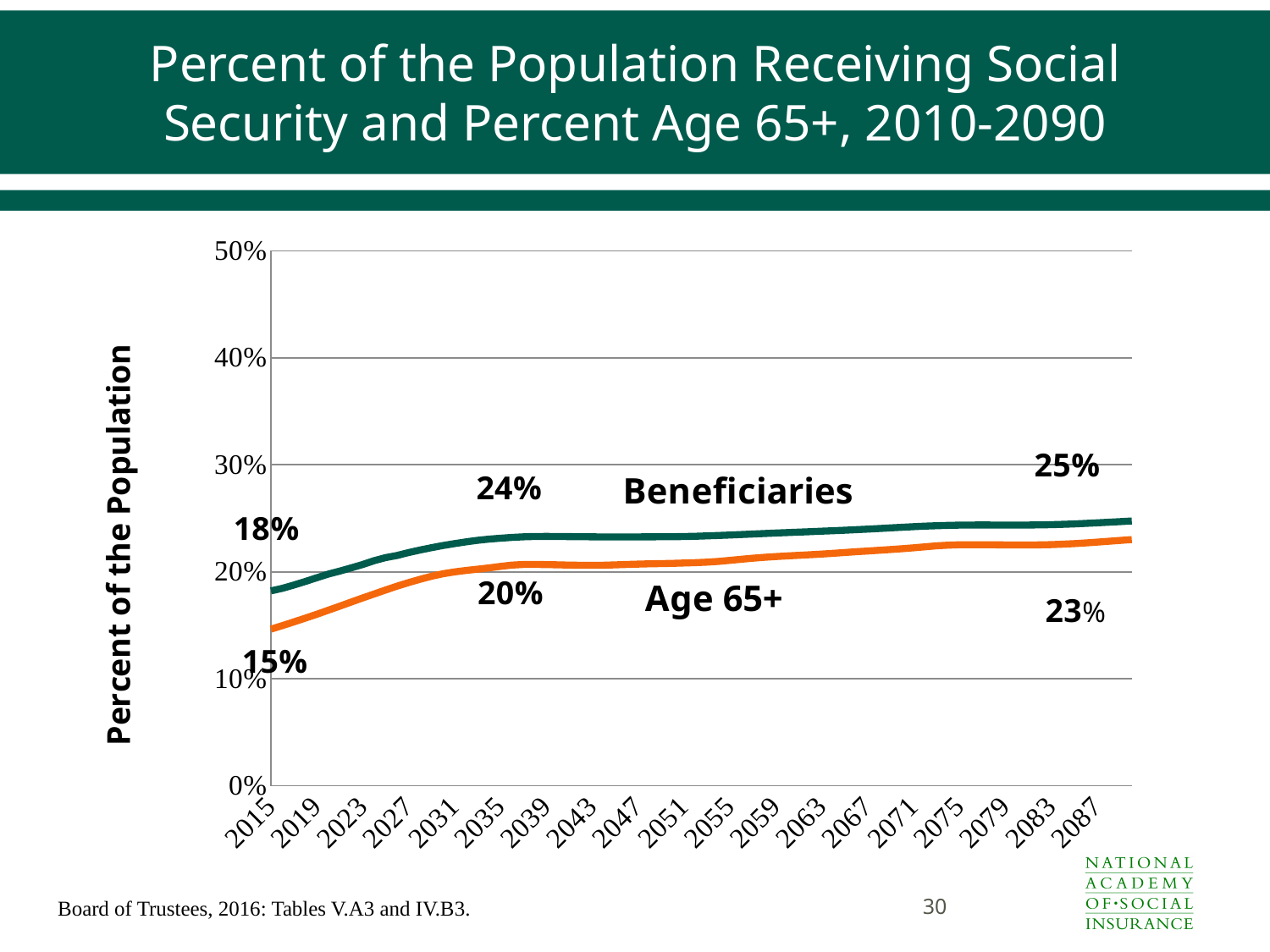
What is the labelled value for Beneficiaries at the end of the period? 25% Which series is higher throughout the chart, Beneficiaries or Age 65+? Beneficiaries What is the labelled value for Age 65+ at the end of the period? 23% What is the label on the vertical axis? Percent of the Population What is the labelled value for Age 65+ around 2035? 20% What is the difference between the labelled Beneficiaries and Age 65+ values at the start of the period (18% vs 15%)? 3% How many series are plotted on the chart? 2 What is the labelled value for Beneficiaries around 2035? 24% Do the Beneficiaries values rise or fall from 2015 to 2087? rise What is the labelled value for Beneficiaries at the start of the period (2015)? 18% What is the labelled value for Age 65+ at the start of the period (2015)? 15% What type of chart is shown on the slide? line chart